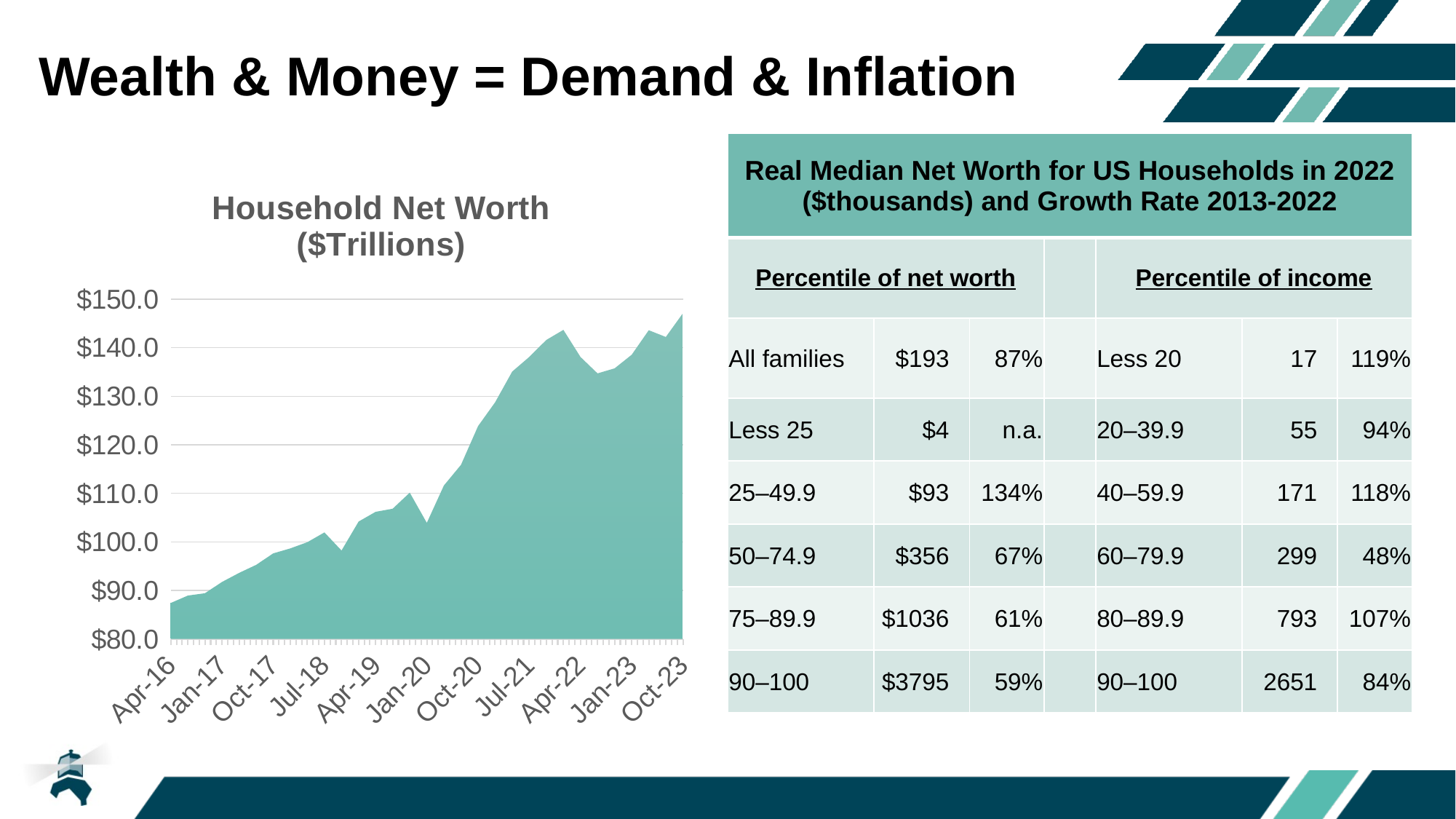
In the Household Net Worth chart, which is larger, the value for Jan-20 or the value for Oct-20? Oct-20 What kind of chart is the Household Net Worth chart? area chart How many date labels are shown on the x axis of the Household Net Worth chart? 11 Is the value for Apr-16 in the Household Net Worth chart greater or less than $90.0? less Is the value for Apr-19 in the Household Net Worth chart greater or less than $100.0? greater Is the value for Jul-21 in the Household Net Worth chart greater or less than $130.0? greater Do the values in the Household Net Worth chart generally rise or fall from Apr-16 to Oct-23? rise Which labelled date on the x axis of the Household Net Worth chart has the lowest value? Apr-16 Which labelled date on the x axis of the Household Net Worth chart has the highest value? Oct-23 What is the title of the chart on the left of the slide? Household Net Worth ($Trillions)